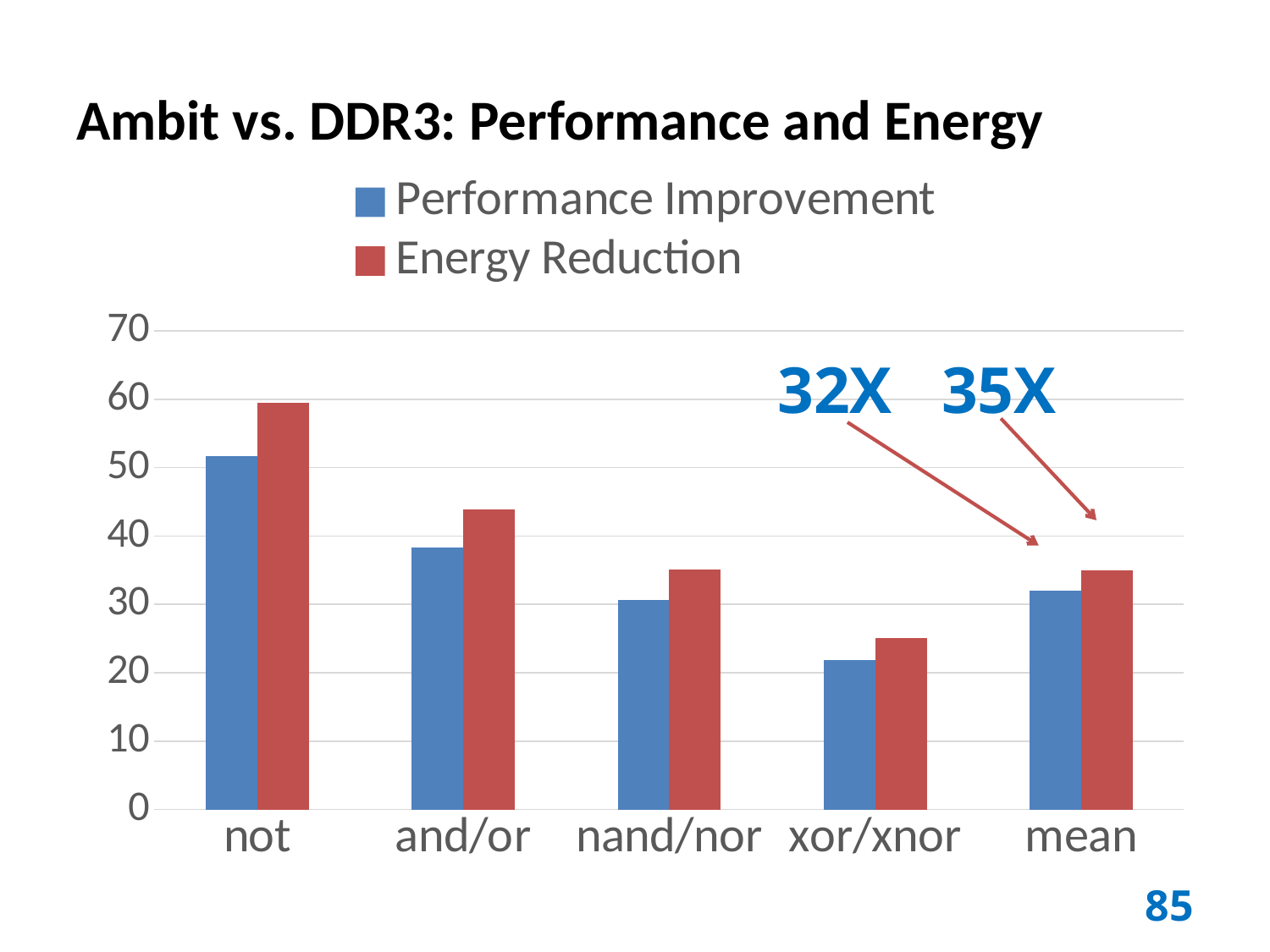
Which category has the lowest Energy Reduction? xor/xnor What annotated value is shown for the mean Performance Improvement? 32X What kind of chart is shown on the slide? bar chart For the not category, which is larger: Performance Improvement or Energy Reduction? Energy Reduction Do the Performance Improvement values rise or fall from not to xor/xnor? fall How many categories are shown on the x axis? 5 Is the Performance Improvement value for xor/xnor greater or less than 30? less How many series does the legend list? 2 Which category has the highest Performance Improvement? not What colour are the Energy Reduction bars? red Is the Energy Reduction value for and/or greater or less than 40? greater Is the Performance Improvement value for not greater or less than 50? greater